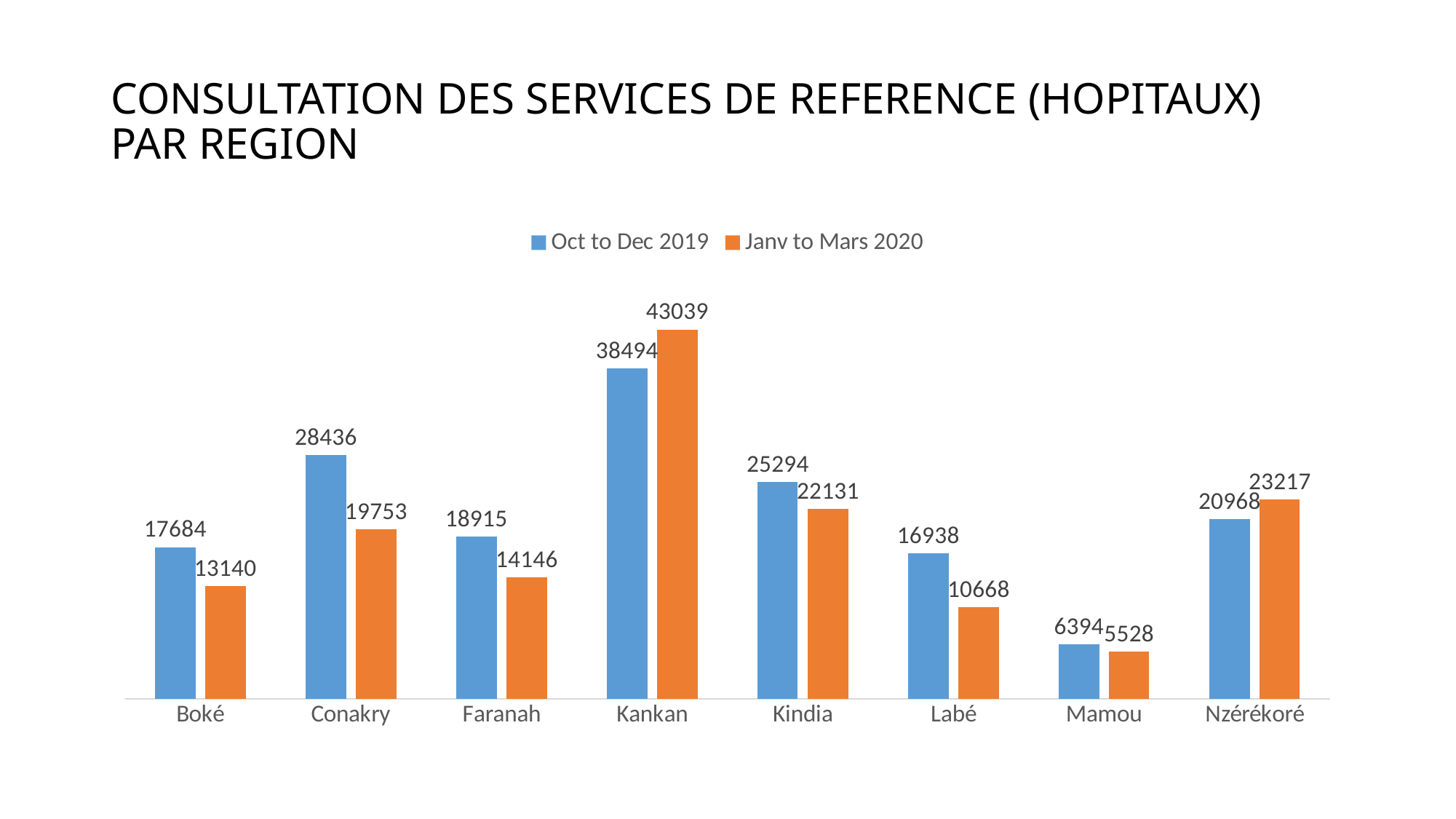
Which region has the lowest value in the Oct to Dec 2019 series? Mamou What is the value for Kankan in the Oct to Dec 2019 series? 38494 Which region has the highest value in the Janv to Mars 2020 series? Kankan What is the difference between the Oct to Dec 2019 and Janv to Mars 2020 values for Conakry? 8683 What kind of chart is shown on the slide? Bar chart How many series does the legend list? 2 Which colour represents the Janv to Mars 2020 series? Orange What is the value for Nzérékoré in the Janv to Mars 2020 series? 23217 Which is larger for Kindia: the Oct to Dec 2019 value or the Janv to Mars 2020 value? Oct to Dec 2019 What is the value for Boké in the Janv to Mars 2020 series? 13140 What is the difference between the Janv to Mars 2020 and Oct to Dec 2019 values for Kankan? 4545 How many regions are shown on the x axis? 8